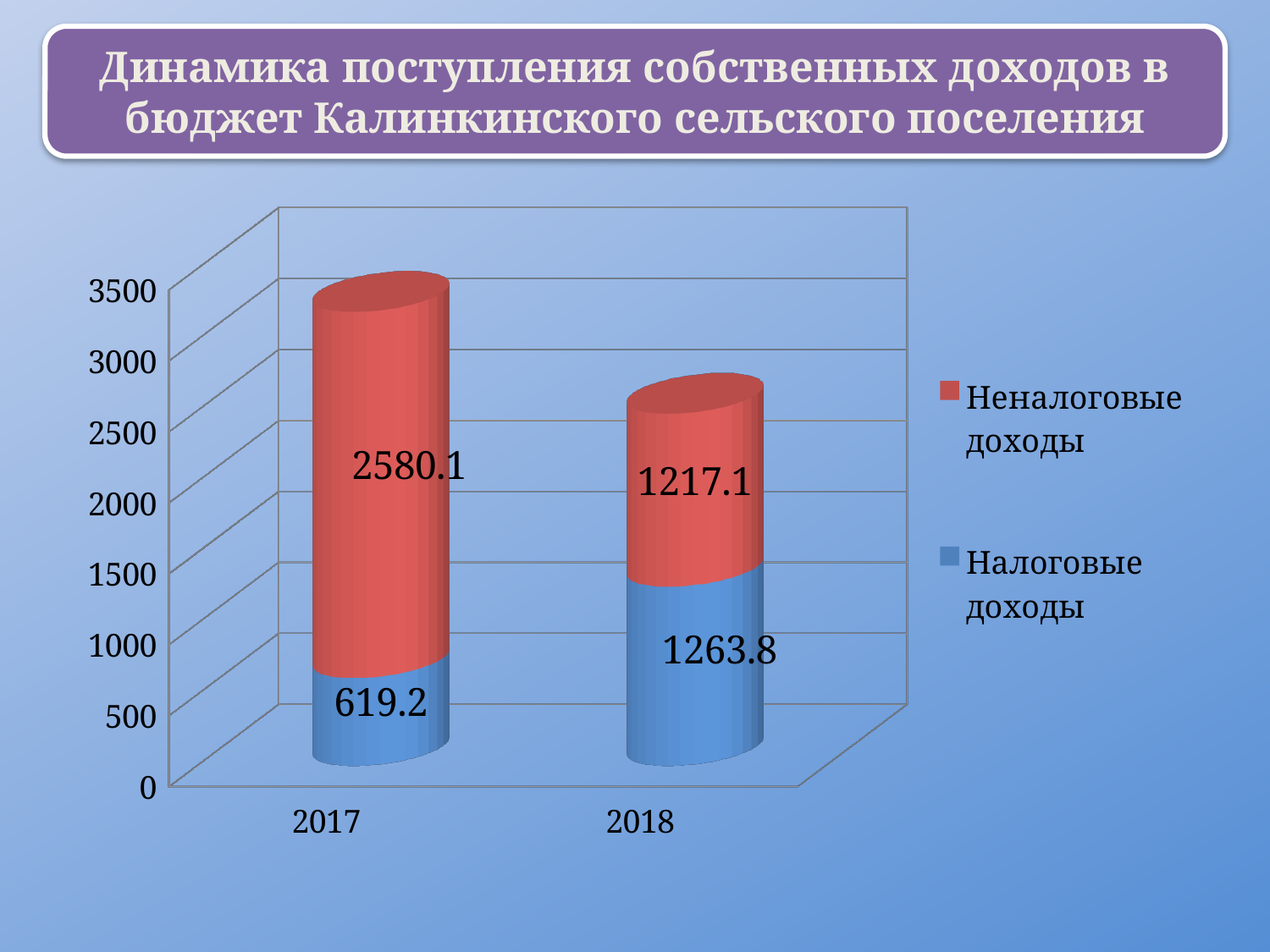
In which year is the value of Неналоговые доходы highest? 2017 What kind of chart is shown on the slide? Stacked bar chart What is the total of the stacked bar for 2018? 2480.9 What is the total of the stacked bar for 2017? 3199.3 Which is larger: Неналоговые доходы in 2017 or Неналоговые доходы in 2018? Неналоговые доходы in 2017 What is the value of Неналоговые доходы for 2017? 2580.1 By how much did Налоговые доходы increase from 2017 to 2018? 644.6 What is the value of Налоговые доходы for 2018? 1263.8 What is the value of Неналоговые доходы for 2018? 1217.1 In which year is the value of Налоговые доходы lowest? 2017 How many series does the legend list? 2 What is the value of Налоговые доходы for 2017? 619.2